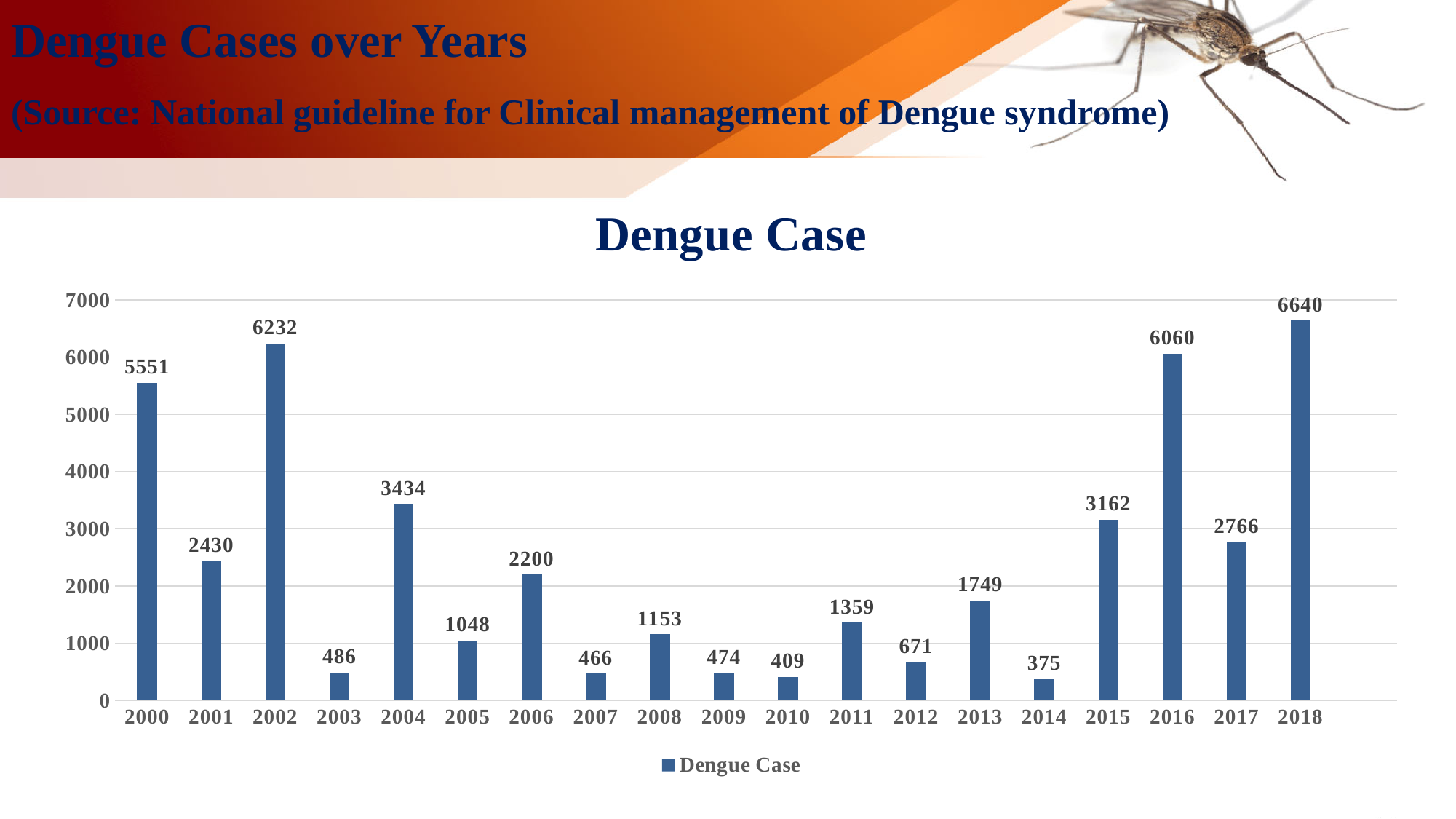
What kind of chart is shown on the slide? Bar chart Is the value for 2015 greater or less than 3000? greater Which year has the highest number of dengue cases? 2018 What is the difference in dengue cases between 2018 and 2017? 3874 What is the title of the chart? Dengue Case What is the difference in dengue cases between 2002 and 2000? 681 What is the number of dengue cases in 2016? 6060 Which year had more dengue cases, 2006 or 2013? 2006 What is the number of dengue cases in 2004? 3434 How many years are shown on the x axis of the chart? 19 How many series does the legend list? 1 Which year has the lowest number of dengue cases? 2014